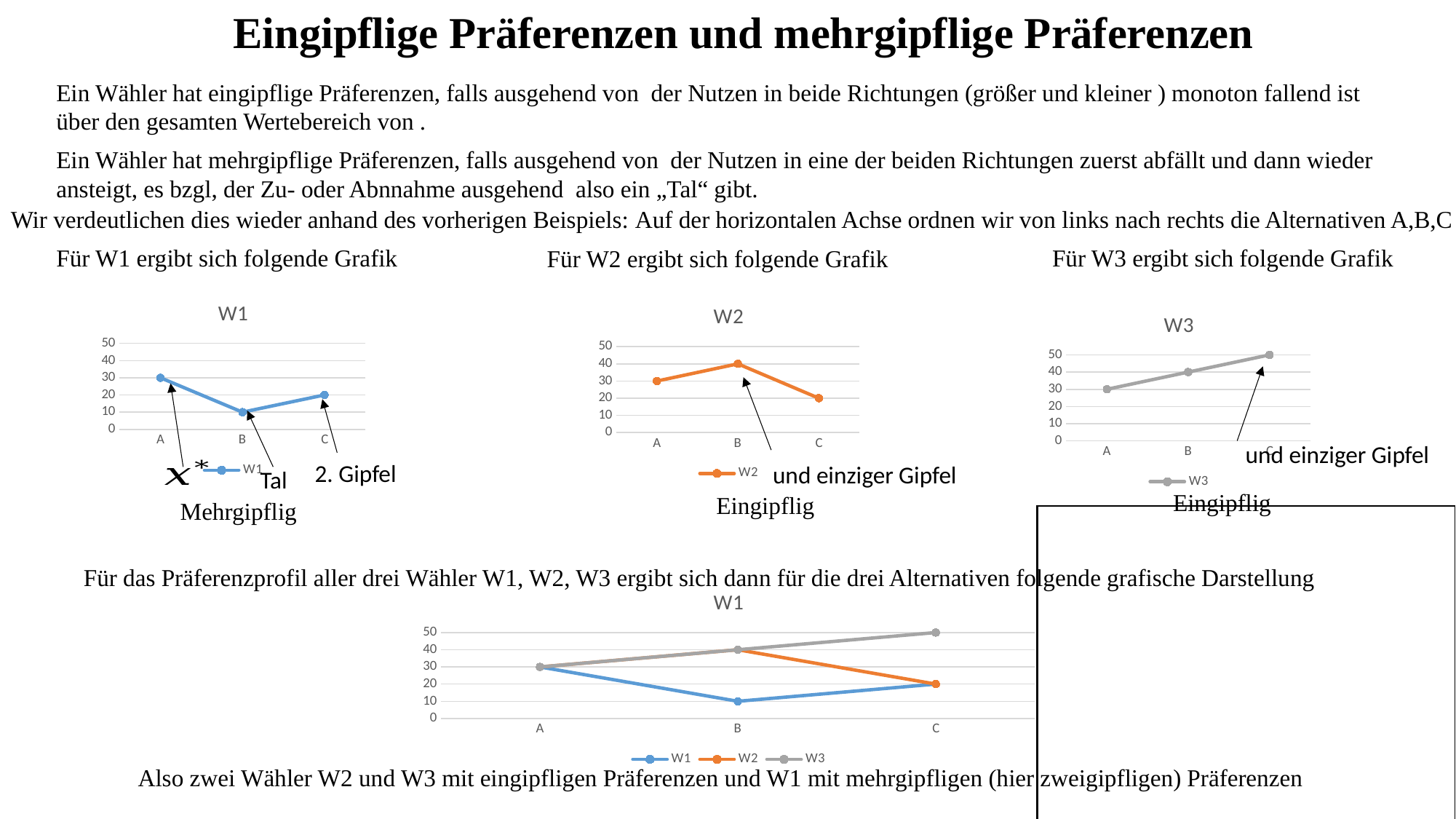
How many alternatives are shown on the x axis of the bottom chart? 3 In the chart titled W3, do the values rise or fall from A to C? rise In the chart titled W2, what is the difference between the values at B and C? 20 What kind of chart is the chart titled W3? line chart In the top-left chart titled W1, what is the value at B? 10 In the chart titled W2, which alternative has the lowest value? C In the chart titled W3, what is the value at C? 50 In the top-left chart titled W1, which is larger, the value at A or the value at C? A In the chart titled W2, what is the value at B? 40 In the top-left chart titled W1, which alternative has the highest value? A How many series does the legend of the bottom chart list? 3 In the bottom chart, what is the value of the W3 series at B? 40